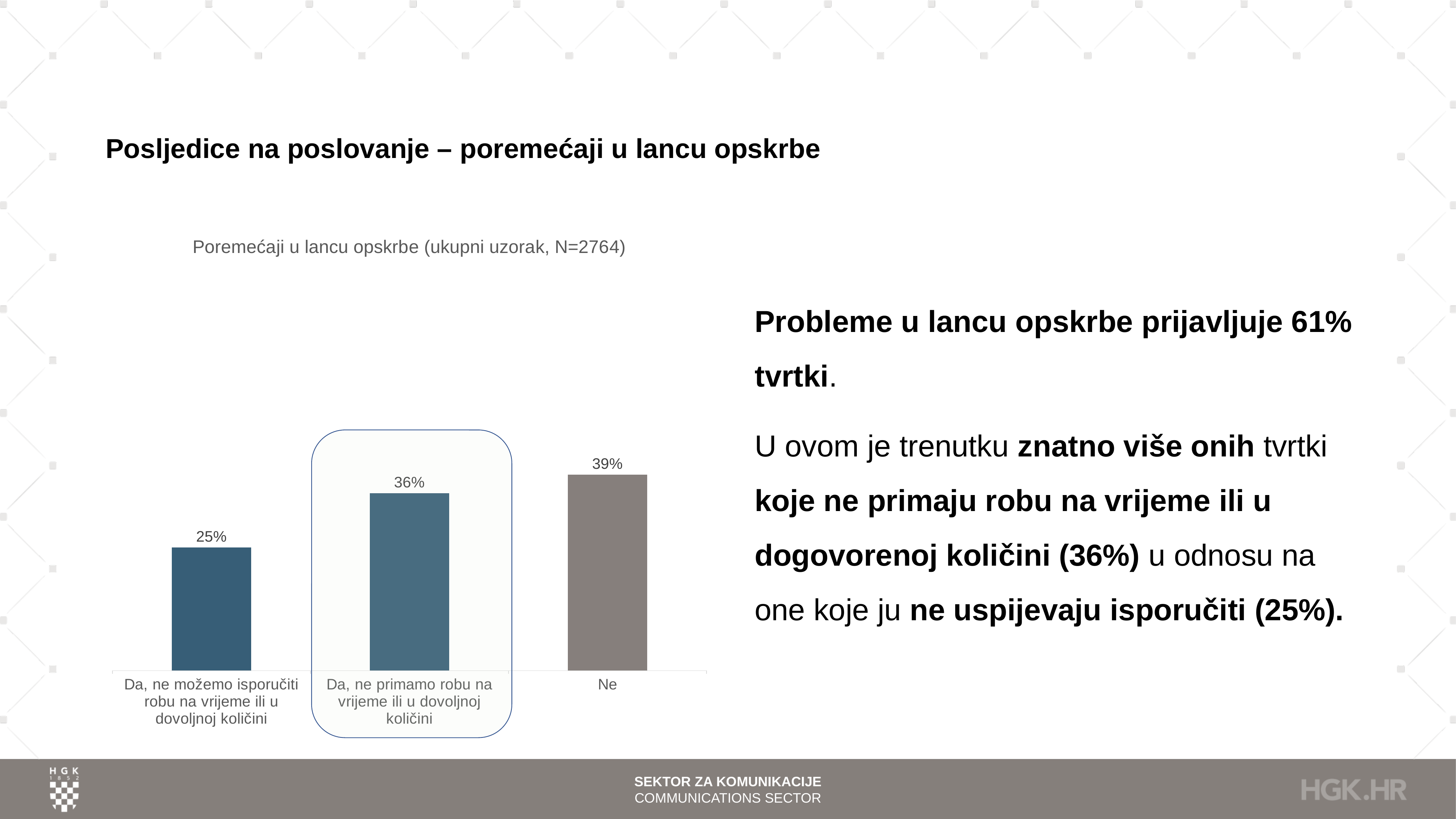
What is the value for "Da, ne možemo isporučiti robu na vrijeme ili u dovoljnoj količini"? 25% What is the difference between the value for "Ne" and the value for "Da, ne možemo isporučiti robu na vrijeme ili u dovoljnoj količini"? 14% What kind of chart is shown on the slide? Bar chart Which category has the lowest value? Da, ne možemo isporučiti robu na vrijeme ili u dovoljnoj količini Which category has the highest value? Ne Which is larger: the value for "Ne" or the value for "Da, ne primamo robu na vrijeme ili u dovoljnoj količini"? Ne What is the value for "Da, ne primamo robu na vrijeme ili u dovoljnoj količini"? 36% What is the difference between the value for "Da, ne primamo robu na vrijeme ili u dovoljnoj količini" and the value for "Da, ne možemo isporučiti robu na vrijeme ili u dovoljnoj količini"? 11% Which category's bar is highlighted with a rounded outline box? Da, ne primamo robu na vrijeme ili u dovoljnoj količini What is the title of the chart? Poremećaji u lancu opskrbe (ukupni uzorak, N=2764) What is the value for "Ne"? 39% How many categories are shown in the chart? 3